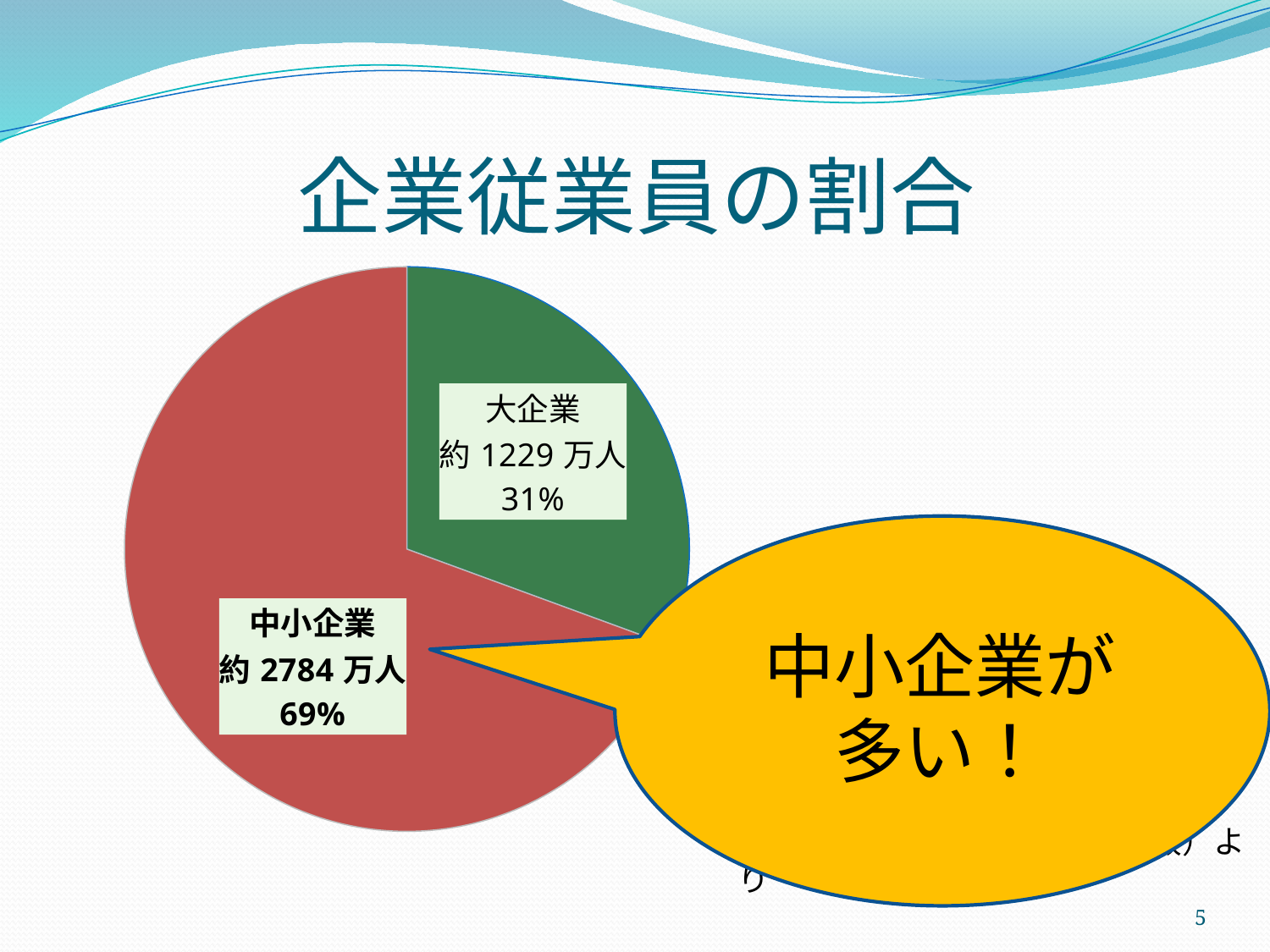
How many slices does the pie chart have? 2 What is the title of the chart on the slide? 企業従業員の割合 What number of employees is labeled for 中小企業 in the pie chart? 約 2784 万人 Which category has the largest slice of the pie? 中小企業 What number of employees is labeled for 大企業 in the pie chart? 約 1229 万人 What colour is the 中小企業 slice of the pie chart? red Which is larger, the share for 中小企業 or the share for 大企業? 中小企業 Which category has the smallest slice of the pie? 大企業 What kind of chart is shown on the slide? pie chart What share of the pie does 大企業 account for? 31% By how many percentage points does the share of 中小企業 exceed the share of 大企業? 38 percentage points What share of the pie does 中小企業 account for? 69%